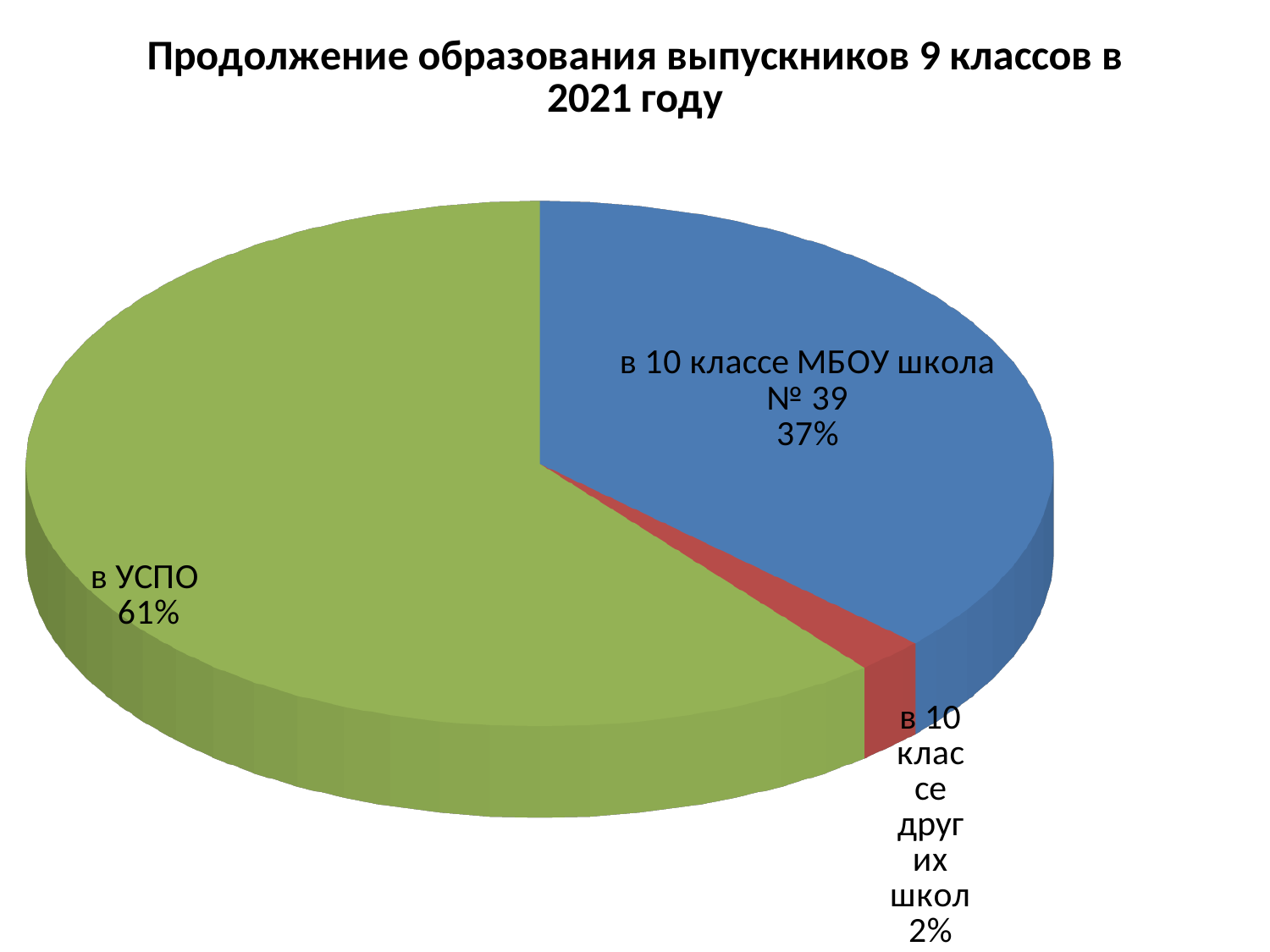
How many slices does the pie chart have? 3 What is the title of the chart? Продолжение образования выпускников 9 классов в 2021 году What share of the pie is labelled "в УСПО"? 61% What is the difference in percentage points between the "в 10 классе МБОУ школа № 39" slice and the "в 10 классе других школ" slice? 35 What kind of chart is shown on the slide? pie chart Which category has the smallest slice of the pie? в 10 классе других школ What share of the pie is labelled "в 10 классе МБОУ школа № 39"? 37% Which is larger: the share for "в 10 классе МБОУ школа № 39" or the share for "в 10 классе других школ"? в 10 классе МБОУ школа № 39 What share of the pie is labelled "в 10 классе других школ"? 2% Which category has the largest slice of the pie? в УСПО What colour is the slice for "в УСПО"? green What is the difference in percentage points between the "в УСПО" slice and the "в 10 классе МБОУ школа № 39" slice? 24